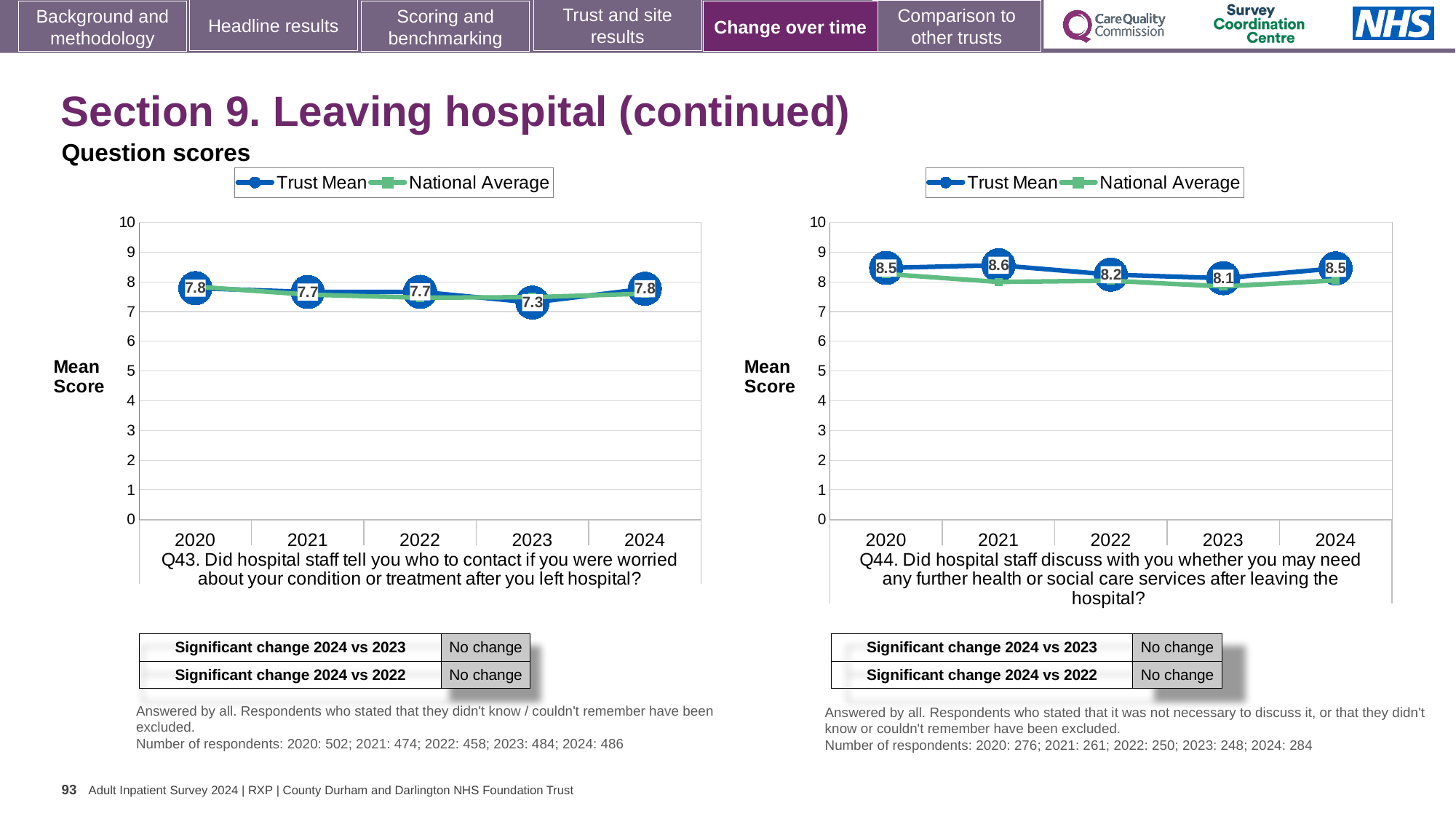
How many series does the legend of the Q44 chart (right) list? 2 How many years are plotted on the x axis of the Q43 chart (left)? 5 In the Q44 chart (right), what is the difference between the Trust Mean scores for 2021 and 2023? 0.5 In the Q44 chart (right), does the Trust Mean score rise or fall from 2021 to 2023? Fall In the Q44 chart (right), what is the Trust Mean score for 2021? 8.6 In the Q43 chart (left), which year has the lowest Trust Mean score? 2023 In the Q43 chart (left), what is the difference between the Trust Mean scores for 2024 and 2023? 0.5 What type of chart is used for the Q43 chart (left)? Line chart In the Q43 chart (left), what is the Trust Mean score for 2023? 7.3 In the Q44 chart (right), which year has the highest Trust Mean score? 2021 In the Q44 chart (right), is the Trust Mean score higher in 2020 or in 2022? 2020 In the Q43 chart (left), is the National Average for 2023 greater or less than 8? less